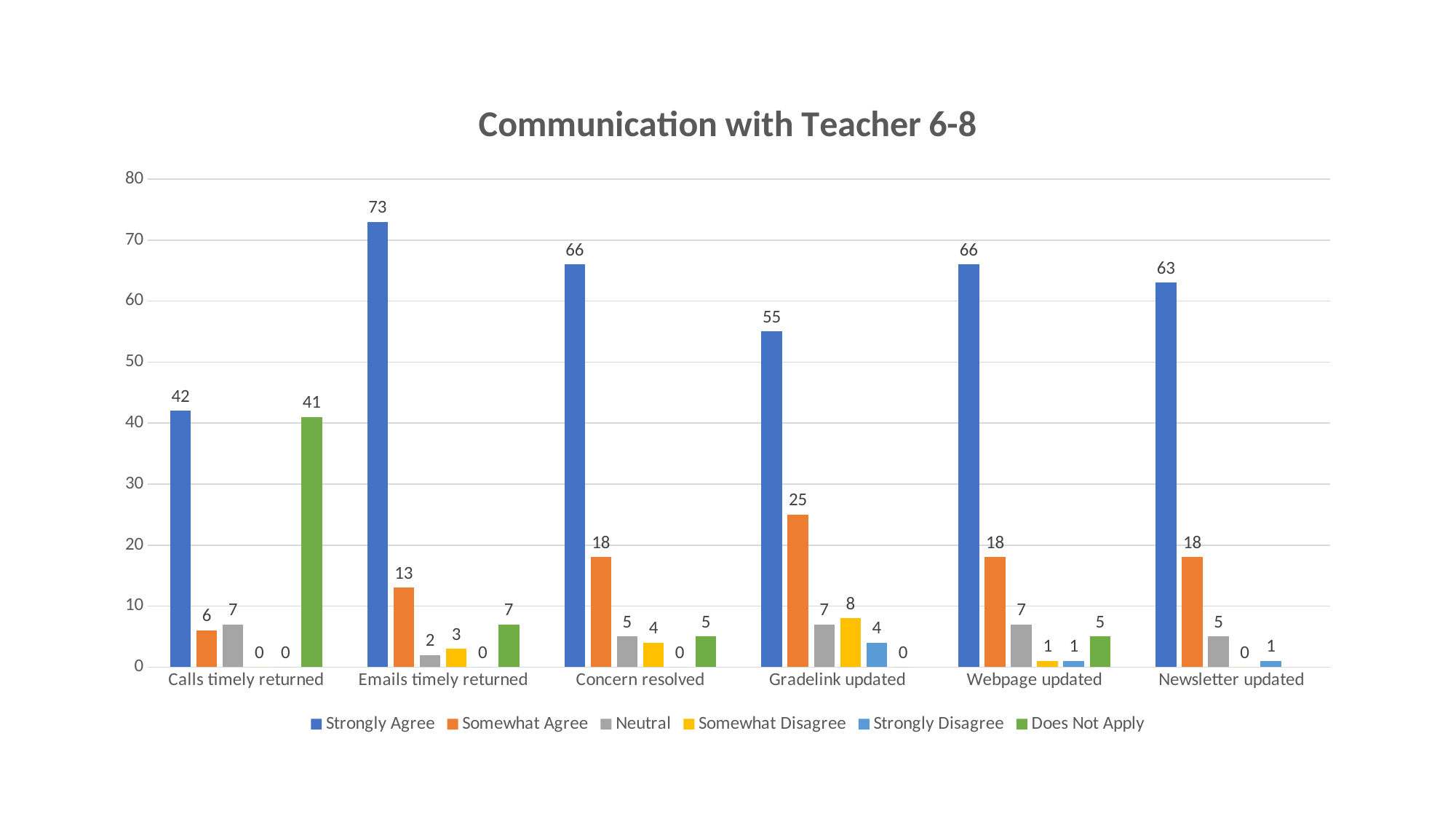
How many series does the legend list? 6 What kind of chart is shown on the slide? Bar chart Which is larger: the Somewhat Agree value for Gradelink updated or for Concern resolved? Gradelink updated Which category has the lowest Strongly Agree value? Calls timely returned Which category has the highest Strongly Agree value? Emails timely returned How many categories are shown on the x axis? 6 What is the Strongly Agree value for Emails timely returned? 73 What is the Somewhat Agree value for Gradelink updated? 25 What is the difference between the Strongly Agree values for Emails timely returned and Calls timely returned? 31 What is the title of the chart? Communication with Teacher 6-8 What is the Does Not Apply value for Calls timely returned? 41 What is the Somewhat Disagree value for Gradelink updated? 8